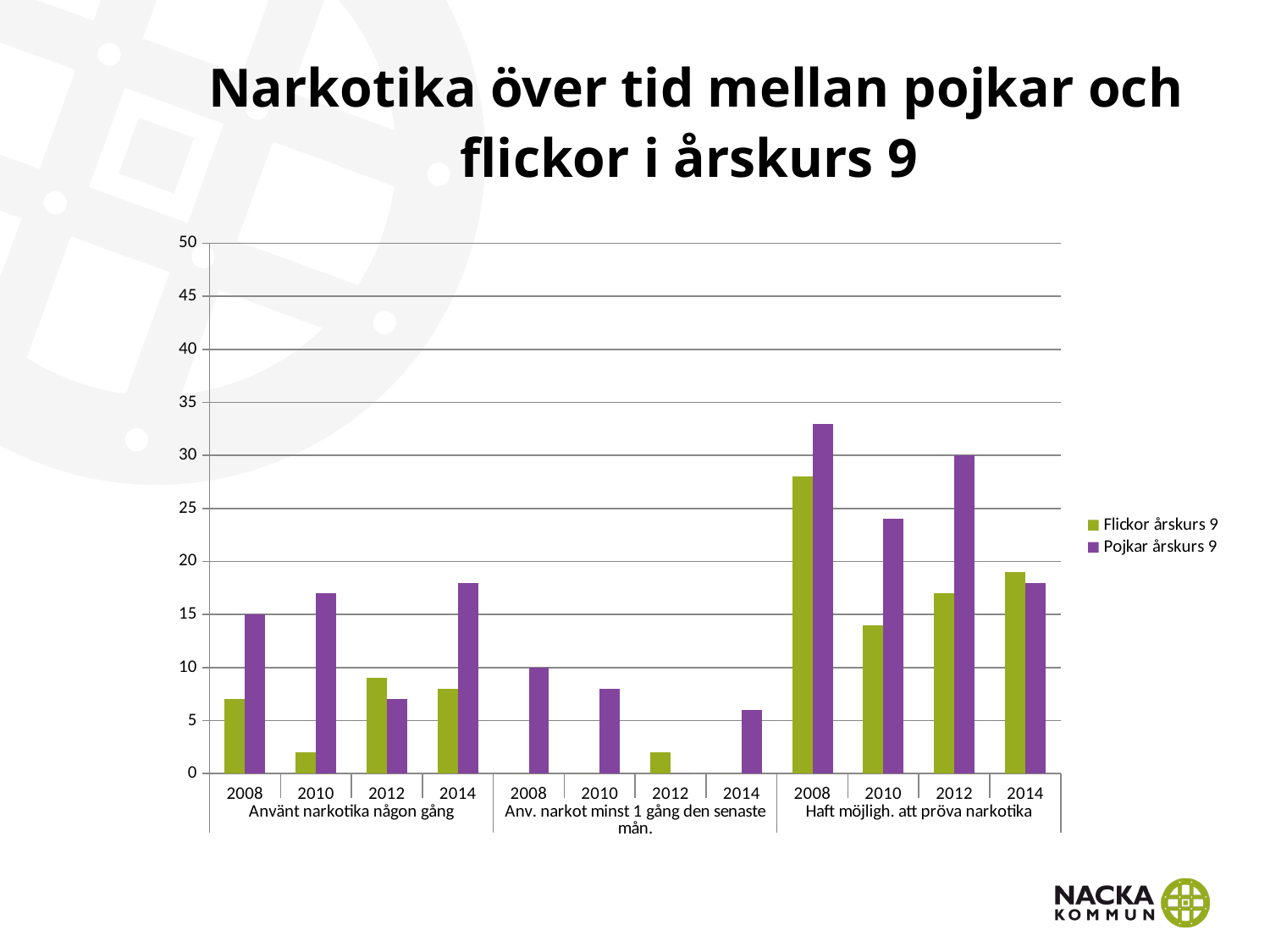
Which bar is the highest in the chart? Pojkar årskurs 9, 2008, Haft möjligh. att pröva narkotika Is the value for Flickor årskurs 9 in 2010 under 'Använt narkotika någon gång' greater or less than 5? less How many category groups are shown along the x axis? 3 Is the value for Pojkar årskurs 9 in 2008 under 'Haft möjligh. att pröva narkotika' greater or less than 30? greater How many series does the legend list? 2 Which series is shown in purple? Pojkar årskurs 9 In 2008 under 'Använt narkotika någon gång', which is larger: Flickor årskurs 9 or Pojkar årskurs 9? Pojkar årskurs 9 What is the value for Pojkar årskurs 9 in 2012 under 'Haft möjligh. att pröva narkotika'? 30 Is the value for Flickor årskurs 9 in 2008 under 'Haft möjligh. att pröva narkotika' greater or less than 30? less What type of chart is shown on the slide? Bar chart What is the value for Pojkar årskurs 9 in 2008 under 'Använt narkotika någon gång'? 15 What is the value for Pojkar årskurs 9 in 2008 under 'Anv. narkot minst 1 gång den senaste mån.'? 10